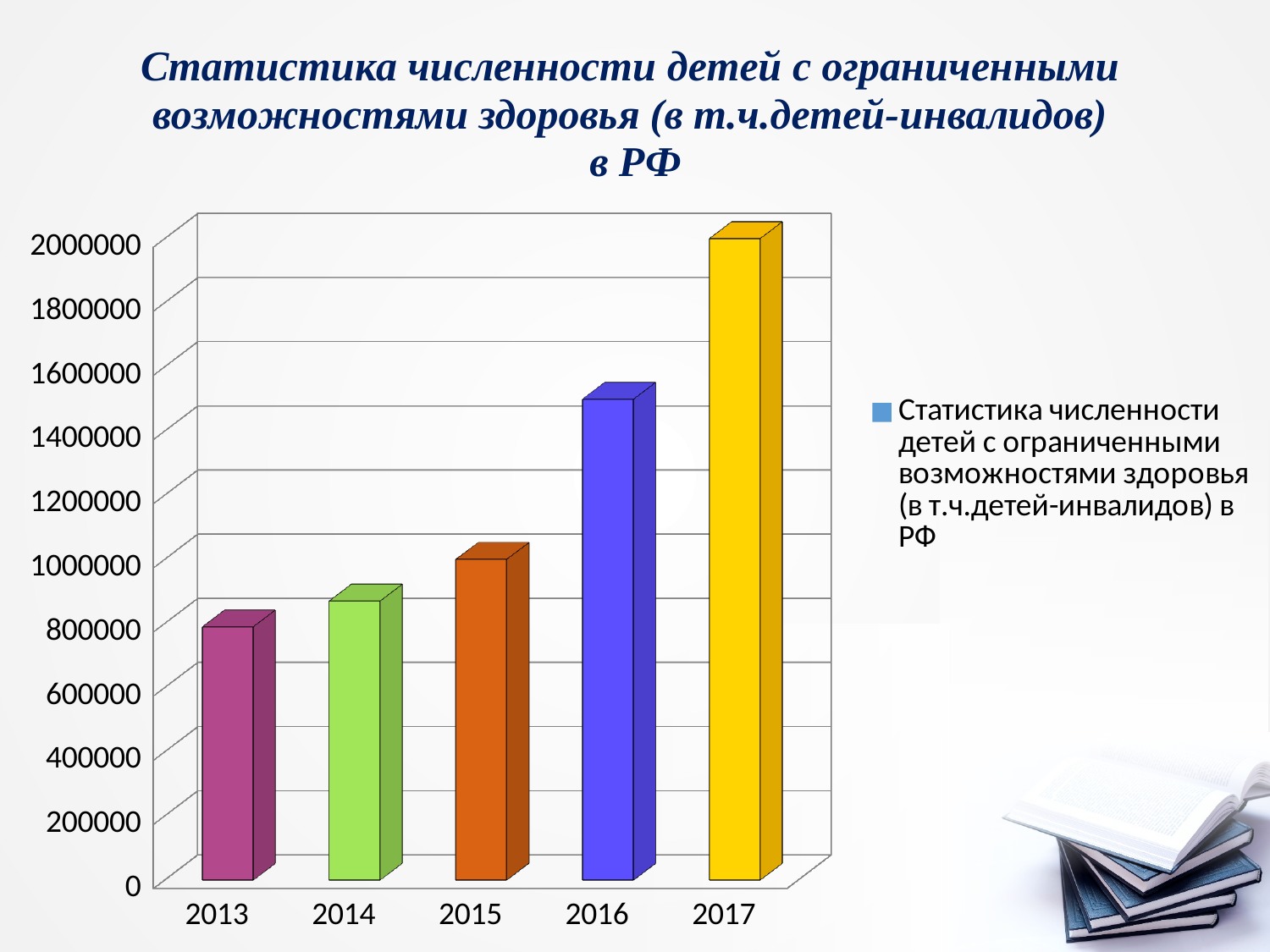
Which year has the lowest value in the chart? 2013 Which year has the larger value, 2015 or 2016? 2016 What kind of chart is shown on the slide? bar chart How many series does the chart legend list? 1 Is the value for 2016 greater or less than 1200000? greater Do the values rise or fall from 2013 to 2017? rise Is the value for 2013 greater or less than 1000000? less Which year has the highest value in the chart? 2017 Is the value for 2014 greater or less than 1000000? less What colour is the bar for 2017? yellow How many years (categories) are shown on the x axis of the chart? 5